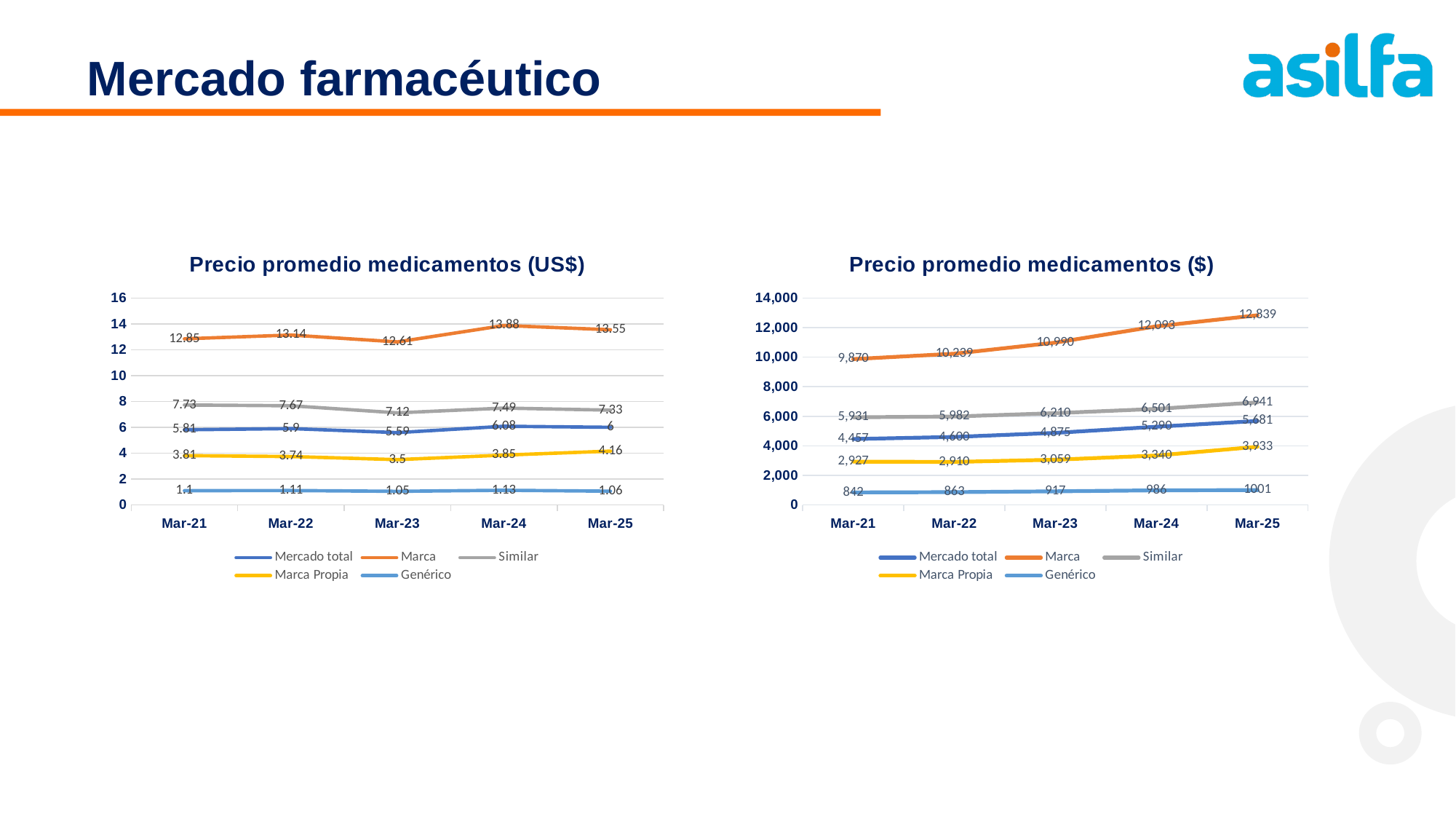
In the chart titled 'Precio promedio medicamentos ($)', does the Marca series rise or fall from Mar-21 to Mar-25? rise In the chart titled 'Precio promedio medicamentos (US$)', what is the value for Marca Propia at Mar-25? 4.16 In the chart titled 'Precio promedio medicamentos (US$)', at which point on the x axis is the Marca series lowest? Mar-23 In the chart titled 'Precio promedio medicamentos ($)', what is the value for Genérico at Mar-21? 842 In the chart titled 'Precio promedio medicamentos (US$)', what is the difference between the Similar and Mercado total values at Mar-21? 1.92 In the chart titled 'Precio promedio medicamentos (US$)', which is larger at Mar-22: Mercado total or Marca Propia? Mercado total In the chart titled 'Precio promedio medicamentos ($)', what is the difference between the Marca values at Mar-25 and Mar-21? 2,969 What kind of chart is the chart titled 'Precio promedio medicamentos (US$)'? line chart In the chart titled 'Precio promedio medicamentos ($)', at which point on the x axis is the Similar series highest? Mar-25 How many series does the legend of the chart titled 'Precio promedio medicamentos ($)' list? 5 In the chart titled 'Precio promedio medicamentos (US$)', what is the value for Marca at Mar-24? 13.88 In the chart titled 'Precio promedio medicamentos ($)', what is the value for Marca at Mar-25? 12,839